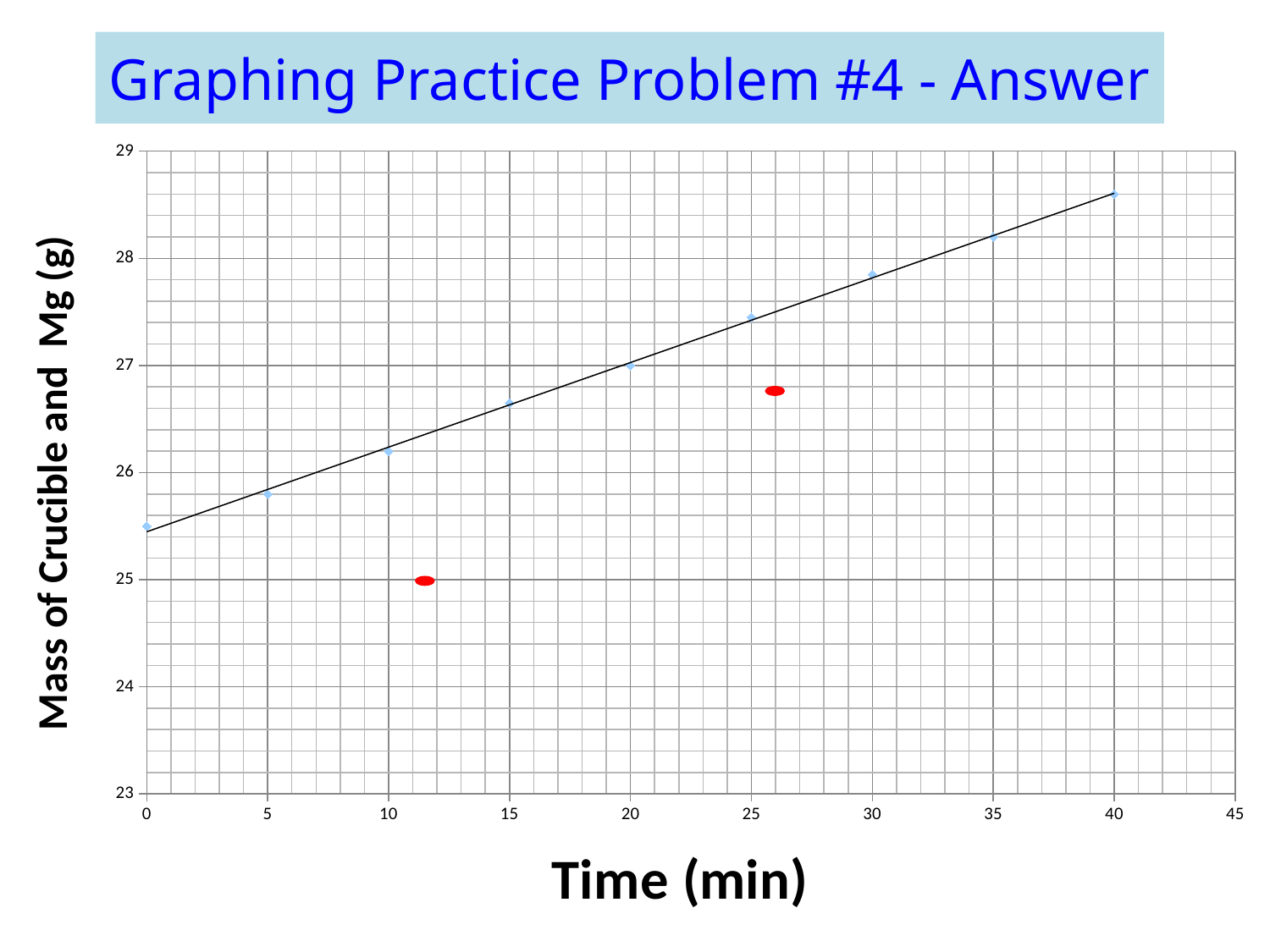
Do the plotted values rise or fall as time increases along the x axis? rise What kind of chart is shown on the slide? scatter chart with a trend line At which time is the mass of crucible and Mg highest? 40 Which has the larger mass, the point at 5 min or the point at 35 min? 35 min Is the mass at 10 min greater or less than 26? greater At which time is the mass of crucible and Mg lowest? 0 What is the mass of crucible and Mg at 20 min? 27 What is the label on the x axis? Time (min) How many blue data points are plotted on the chart? 9 Is the mass at 40 min greater or less than 28? greater Is the mass at 30 min greater or less than 28? less What is the label on the y axis? Mass of Crucible and Mg (g)